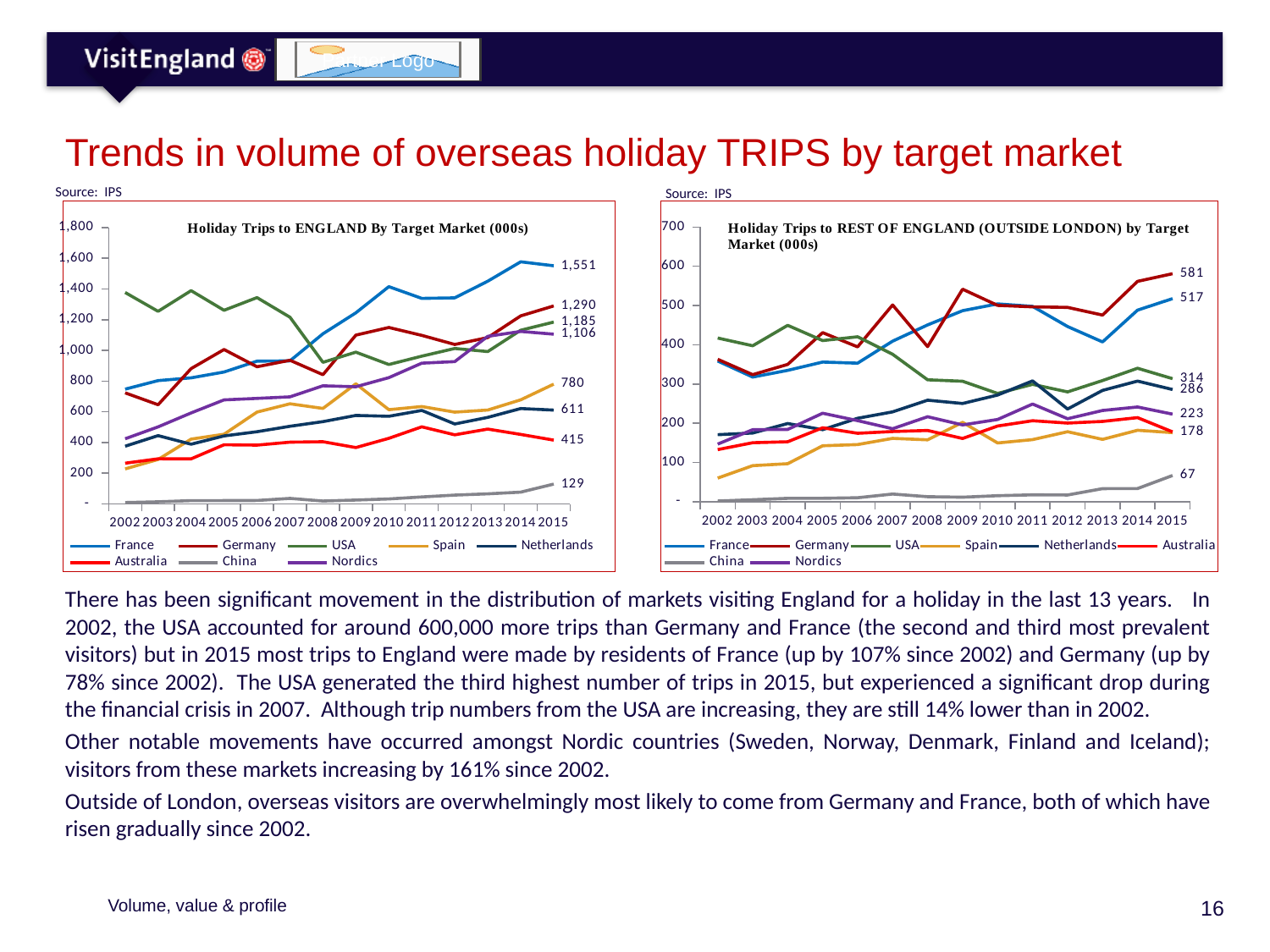
In the chart titled 'Holiday Trips to ENGLAND By Target Market (000s)', how many series does the legend list? 8 In the chart titled 'Holiday Trips to ENGLAND By Target Market (000s)', what is the value for Germany in 2015? 1,290 In the chart titled 'Holiday Trips to ENGLAND By Target Market (000s)', which market has the highest value in 2015? France In the chart titled 'Holiday Trips to ENGLAND By Target Market (000s)', what is the value for France in 2015? 1,551 In the chart titled 'Holiday Trips to ENGLAND By Target Market (000s)', what is the difference between the 2015 values for France and Germany? 261 In the chart titled 'Holiday Trips to REST OF ENGLAND (OUTSIDE LONDON) by Target Market (000s)', what is the difference between the 2015 values for Germany and France? 64 What kind of chart is the chart on the right of the slide? Line chart In the chart titled 'Holiday Trips to ENGLAND By Target Market (000s)', how many years are shown on the x axis? 14 In the chart titled 'Holiday Trips to ENGLAND By Target Market (000s)', which market has the lowest value in 2015? China In the chart titled 'Holiday Trips to ENGLAND By Target Market (000s)', what is the value for China in 2015? 129 In the chart titled 'Holiday Trips to ENGLAND By Target Market (000s)', is the value for the USA in 2002 greater or less than 1,200? greater In the chart titled 'Holiday Trips to REST OF ENGLAND (OUTSIDE LONDON) by Target Market (000s)', what is the value for Germany in 2015? 581